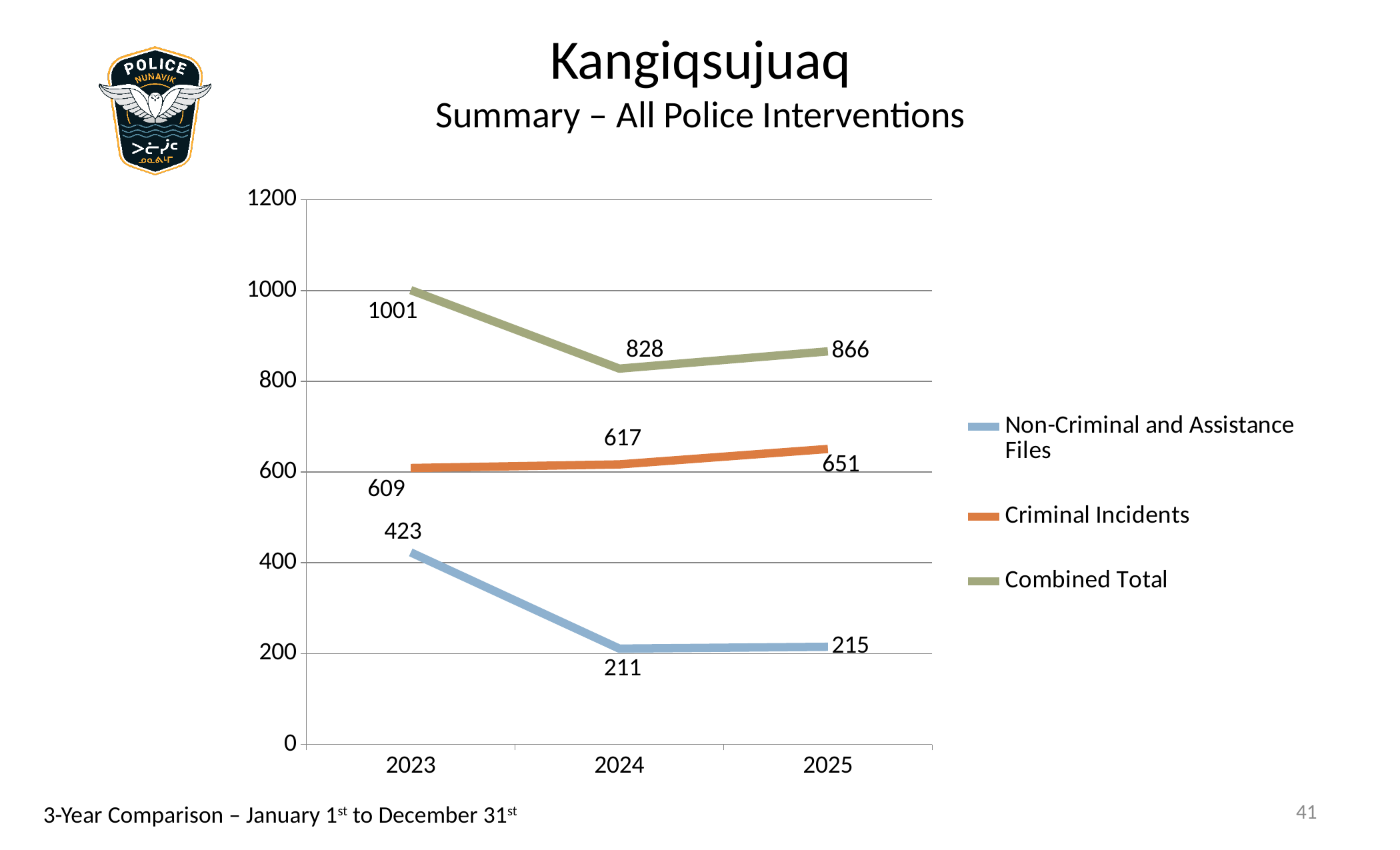
How many series does the legend list? 3 What is the value for Non-Criminal and Assistance Files in 2024? 211 What is the value for Criminal Incidents in 2025? 651 What is the difference between Criminal Incidents in 2025 and in 2023? 42 What is the difference between the Combined Total in 2023 and in 2024? 173 What kind of chart is shown on the slide? Line chart How many years are shown on the x axis? 3 Does the Criminal Incidents series rise or fall from 2023 to 2025? Rise In which year is the Non-Criminal and Assistance Files value highest? 2023 What is the Combined Total value for 2023? 1001 Which is larger: Criminal Incidents in 2024 or Non-Criminal and Assistance Files in 2024? Criminal Incidents in 2024 In which year is the Combined Total lowest? 2024